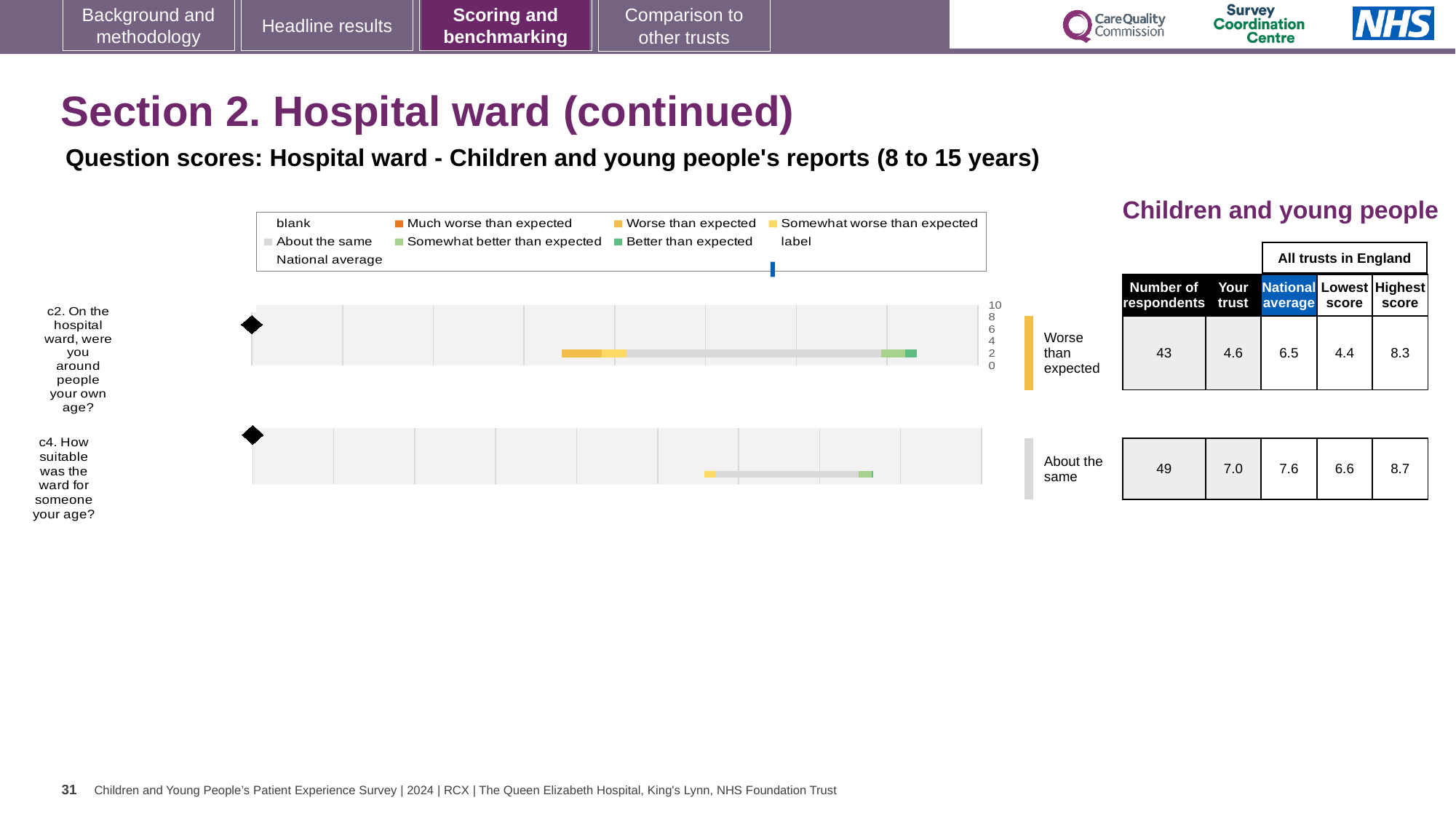
How many respondents answered question c2? 43 What is the difference between the highest score and the lowest score for question c4? 2.1 What is the 'Your trust' score for question c2 (On the hospital ward, were you around people your own age?)? 4.6 What is the national average score for question c4 (How suitable was the ward for someone your age?)? 7.6 What is the highest score among all trusts in England for question c4? 8.7 What benchmark category is shown for question c2? Worse than expected For question c2, which is larger: the 'Your trust' score or the national average? National average Which question has the higher 'Your trust' score, c2 or c4? c4 What kind of chart is used to show the question scores on this slide? Bar chart What is the lowest score among all trusts in England for question c2? 4.4 How many questions are plotted on this slide? 2 By how much does the national average exceed the 'Your trust' score for question c2? 1.9